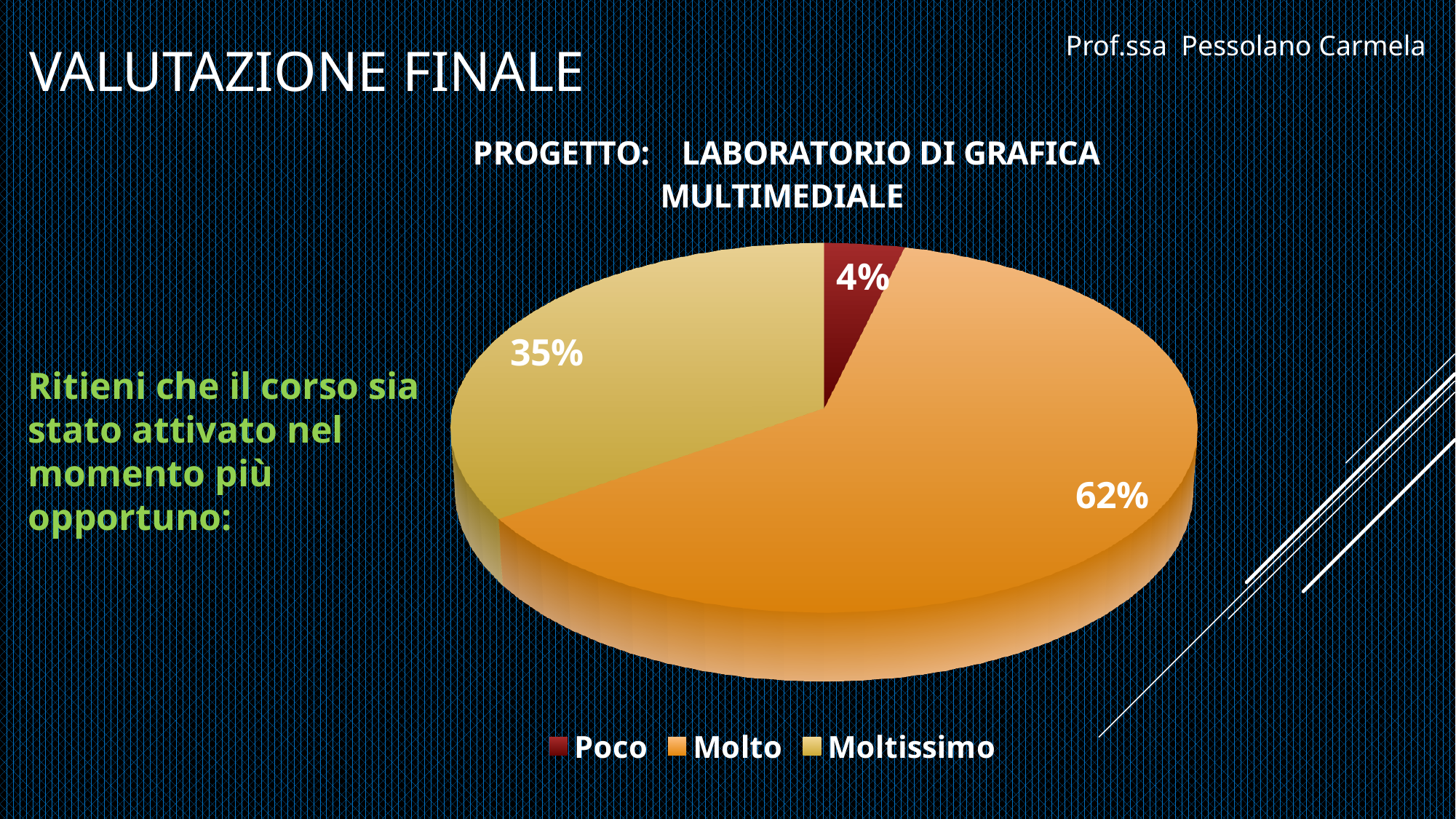
What kind of chart is shown on the slide? Pie chart What percentage of the pie is labelled "Poco"? 4% Which slice is larger, "Moltissimo" or "Poco"? Moltissimo How many entries does the legend list? 3 How many slices does the pie chart have? 3 What is the difference in percentage points between the "Molto" and "Moltissimo" slices? 27 What percentage of the pie is labelled "Moltissimo"? 35% What percentage of the pie is labelled "Molto"? 62% What colour is the "Poco" slice in the pie chart? Dark red What is the title of the chart? PROGETTO: LABORATORIO DI GRAFICA MULTIMEDIALE Which category has the largest slice of the pie? Molto Which category has the smallest slice of the pie? Poco